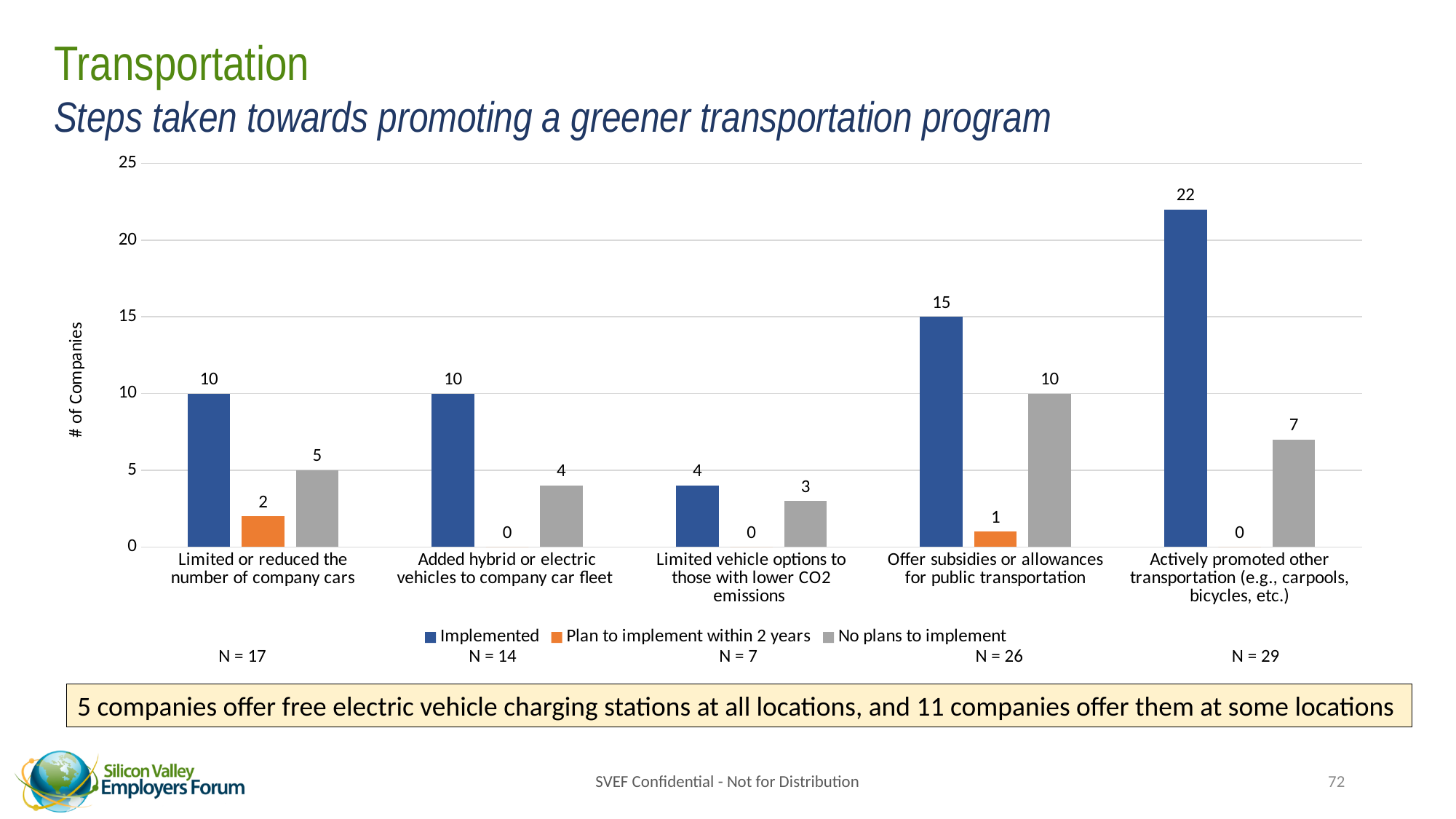
How many companies have implemented 'Actively promoted other transportation (e.g., carpools, bicycles, etc.)'? 22 What is the 'No plans to implement' value for 'Limited vehicle options to those with lower CO2 emissions'? 3 What kind of chart is shown on the slide? Bar chart How many companies plan to implement 'Limited or reduced the number of company cars' within 2 years? 2 How many categories are shown on the x axis? 5 What is the difference between the 'Implemented' and 'No plans to implement' values for 'Offer subsidies or allowances for public transportation'? 5 Which category has the lowest 'Implemented' value? Limited vehicle options to those with lower CO2 emissions What is the label of the y axis? # of Companies How many series does the legend list? 3 What is the 'No plans to implement' value for 'Offer subsidies or allowances for public transportation'? 10 Which category has the highest 'Implemented' value? Actively promoted other transportation (e.g., carpools, bicycles, etc.) Which is larger: the 'Implemented' value for 'Added hybrid or electric vehicles to company car fleet' or the 'Implemented' value for 'Limited vehicle options to those with lower CO2 emissions'? Added hybrid or electric vehicles to company car fleet